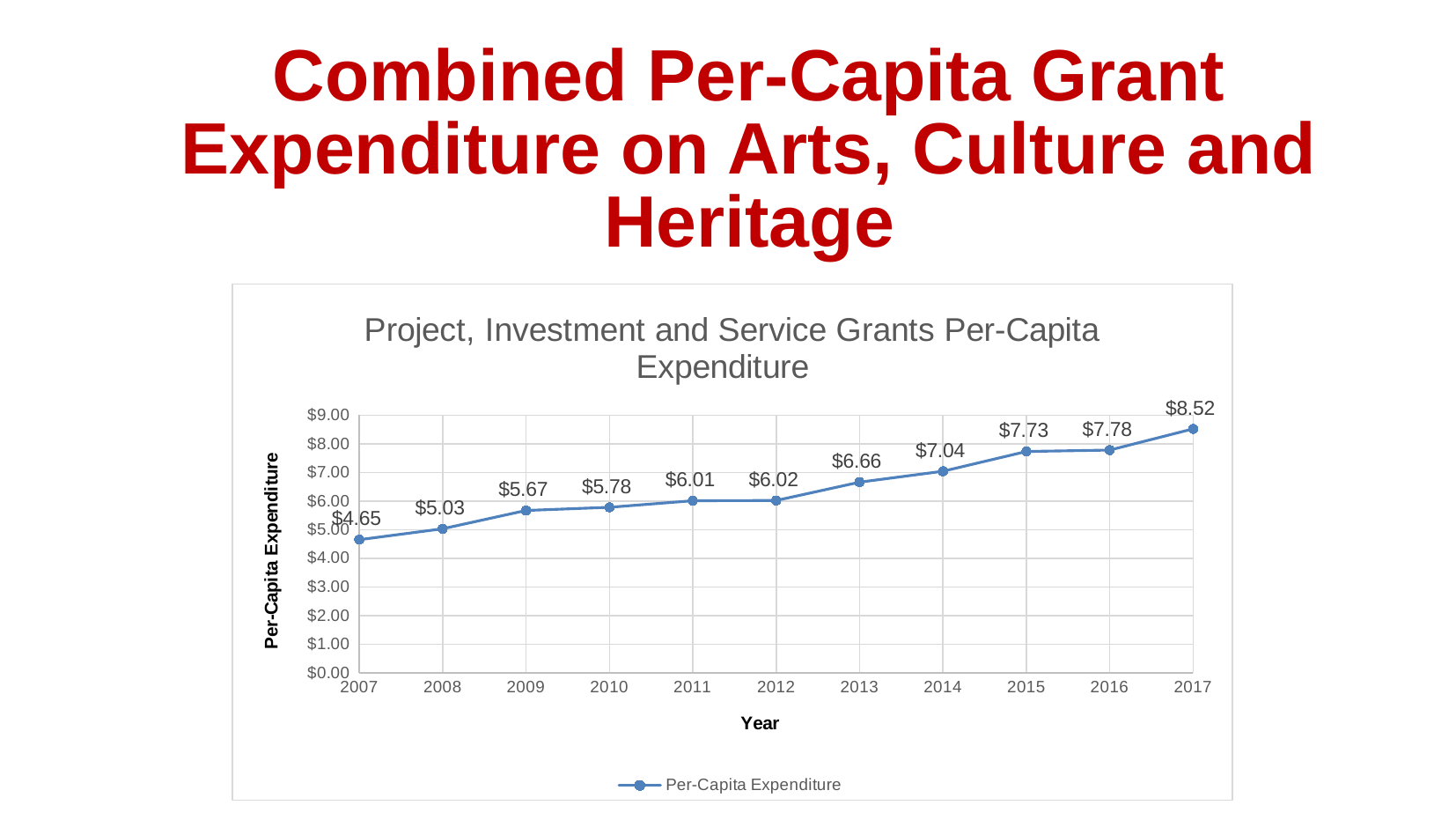
How many years are plotted on the chart? 11 Which year has the highest per-capita expenditure? 2017 What is the difference between the per-capita expenditure in 2017 and in 2007? $3.87 Which year has a higher per-capita expenditure, 2009 or 2015? 2015 What is the per-capita expenditure for 2007? $4.65 What is the difference between the per-capita expenditure in 2014 and in 2013? $0.38 What kind of chart is shown on the slide? Line chart What is the per-capita expenditure for 2013? $6.66 Does the per-capita expenditure generally rise or fall from 2007 to 2017? Rise What is the per-capita expenditure for 2016? $7.78 Is the per-capita expenditure for 2010 greater or less than $6.00? less Which year has the lowest per-capita expenditure? 2007